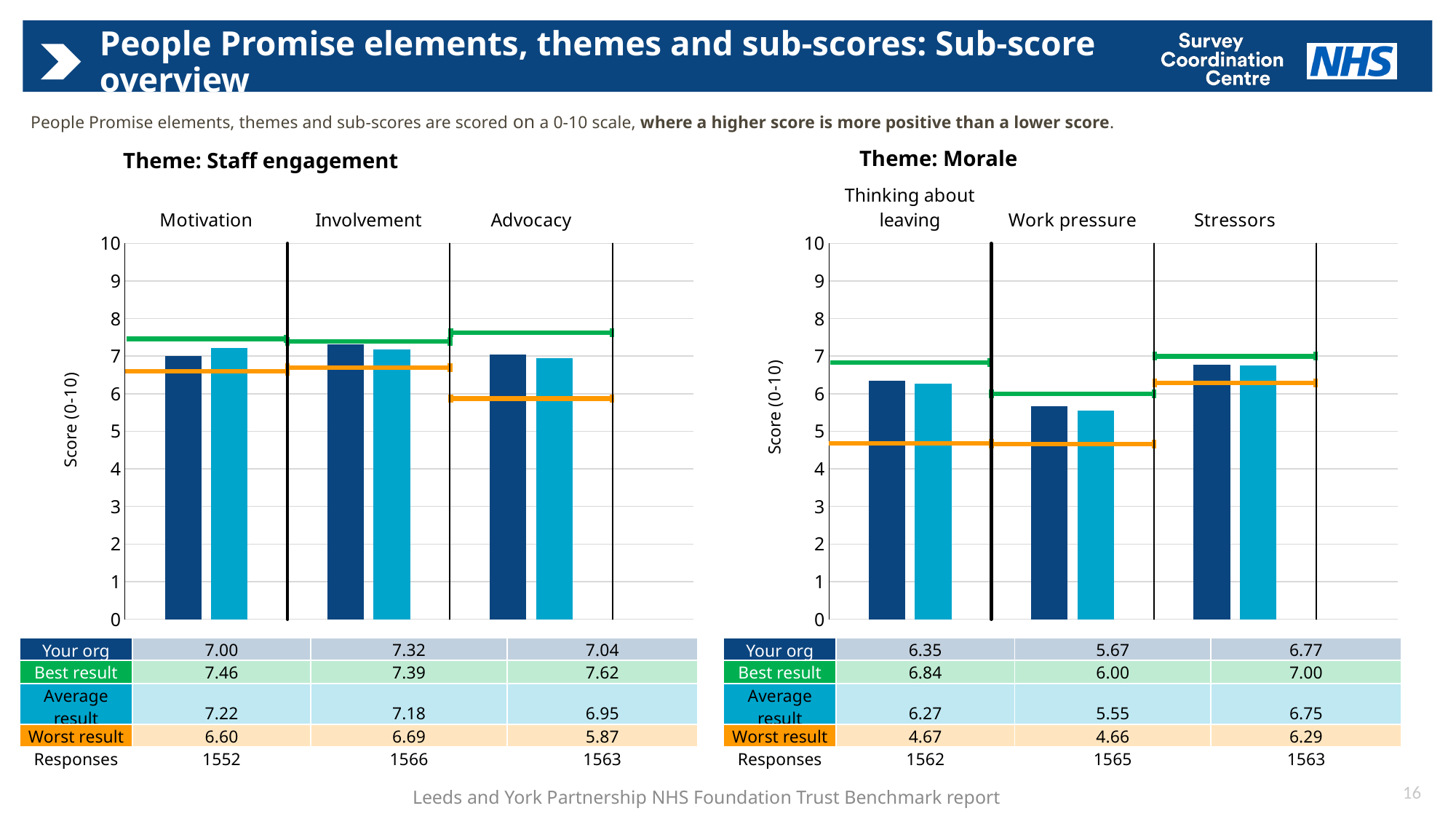
In the Theme: Staff engagement chart, is the Your org value for Motivation greater or less than 8? less What is the y-axis label on the Theme: Morale chart? Score (0-10) What kind of chart is the Theme: Staff engagement chart? bar chart In the Theme: Staff engagement chart, what is the difference between the Your org score and the Average result for Motivation? 0.22 In the Theme: Staff engagement chart, which sub-score has the highest Your org value? Involvement In the Theme: Morale chart, is the Your org score for Stressors larger or smaller than the Average result for Stressors? larger In the Theme: Morale chart, how many responses are recorded for Thinking about leaving? 1562 How many sub-scores are shown in the Theme: Morale chart? 3 In the Theme: Staff engagement chart, what is the difference between the Best result and the Worst result for Advocacy? 1.75 In the Theme: Morale chart, which sub-score has the lowest Your org value? Work pressure In the Theme: Morale chart, what is the Worst result for Work pressure? 4.66 In the Theme: Staff engagement chart, what is the Your org score for Involvement? 7.32